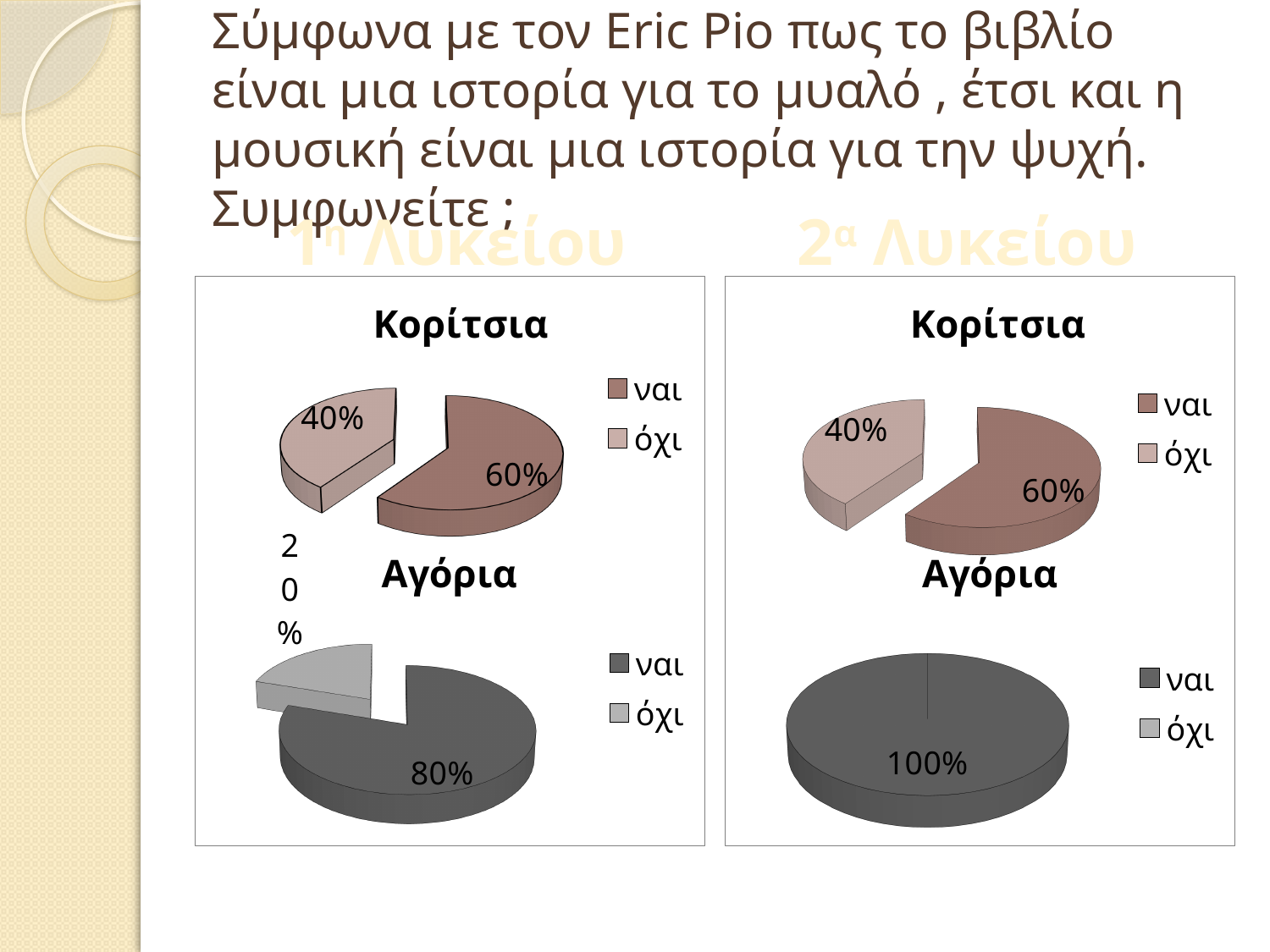
In the top-right pie chart (Κορίτσια, 2α Λυκείου), what percentage answered όχι? 40% In the top-right pie chart (Κορίτσια, 2α Λυκείου), which answer has the smallest slice? όχι What type of chart is used for the Αγόρια data in the 2α Λυκείου panel? pie chart How many entries does the legend of the top-left pie chart (Κορίτσια, 1η Λυκείου) list? 2 In the bottom-left pie chart (Αγόρια, 1η Λυκείου), what percentage answered ναι? 80% In the bottom-left pie chart (Αγόρια, 1η Λυκείου), what percentage answered όχι? 20% In the top-left pie chart (Κορίτσια, 1η Λυκείου), what percentage answered όχι? 40% Which is larger in the top-left pie chart (Κορίτσια, 1η Λυκείου): the ναι slice or the όχι slice? ναι In the bottom-left pie chart (Αγόρια, 1η Λυκείου), which answer has the largest slice? ναι In the bottom-left pie chart (Αγόρια, 1η Λυκείου), what is the difference in percentage points between ναι and όχι? 60 In the top-left pie chart (Κορίτσια, 1η Λυκείου), what percentage answered ναι? 60% In the bottom-right pie chart (Αγόρια, 2α Λυκείου), what percentage answered ναι? 100%